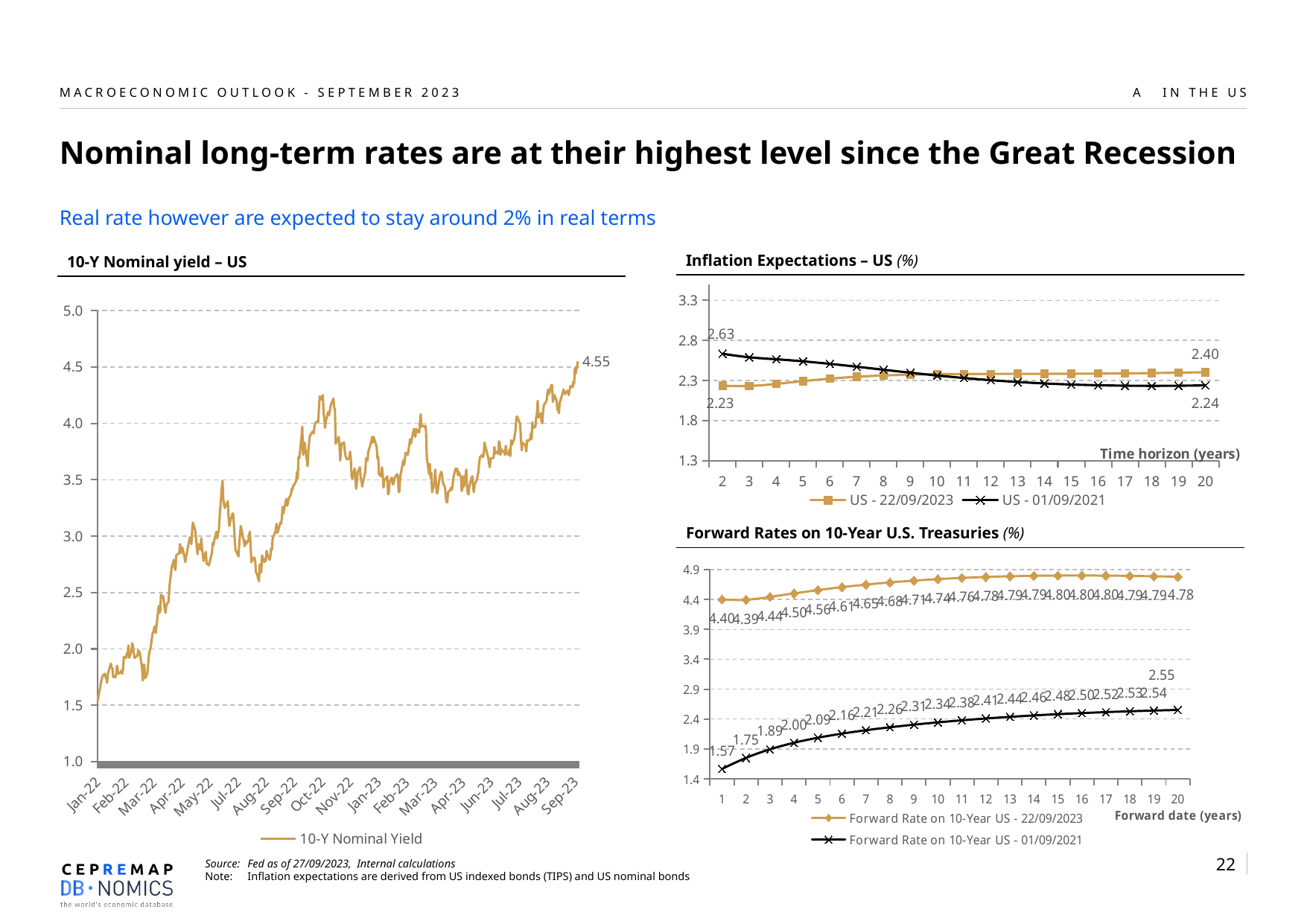
On the Inflation Expectations – US chart, what is the value of the US - 01/09/2021 series at a time horizon of 2 years? 2.63 On the Inflation Expectations – US chart, what is the difference between the two series at a time horizon of 2 years (2.63 vs 2.23)? 0.40 On the Forward Rates on 10-Year U.S. Treasuries chart, what is the difference between the 22/09/2023 and 01/09/2021 forward rates at a forward date of 1 year? 2.83 How many series does the legend of the Inflation Expectations – US chart list? 2 On the Forward Rates on 10-Year U.S. Treasuries chart, what is the Forward Rate on 10-Year US - 01/09/2021 at a forward date of 1 year? 1.57 What kind of chart is the 10-Y Nominal yield – US chart? line chart On the Inflation Expectations – US chart, what is the value of the US - 22/09/2023 series at a time horizon of 20 years? 2.40 On the 10-Y Nominal yield – US chart, what is the latest value labelled at the end of the line (Sep-23)? 4.55 On the Inflation Expectations – US chart, which series is higher at a time horizon of 20 years? US - 22/09/2023 On the Forward Rates on 10-Year U.S. Treasuries chart, what is the Forward Rate on 10-Year US - 22/09/2023 at a forward date of 20 years? 4.78 On the Forward Rates on 10-Year U.S. Treasuries chart, does the Forward Rate on 10-Year US - 01/09/2021 rise or fall as the forward date increases? rise On the 10-Y Nominal yield – US chart, is the yield in Jan-22 greater or less than 2.0? less